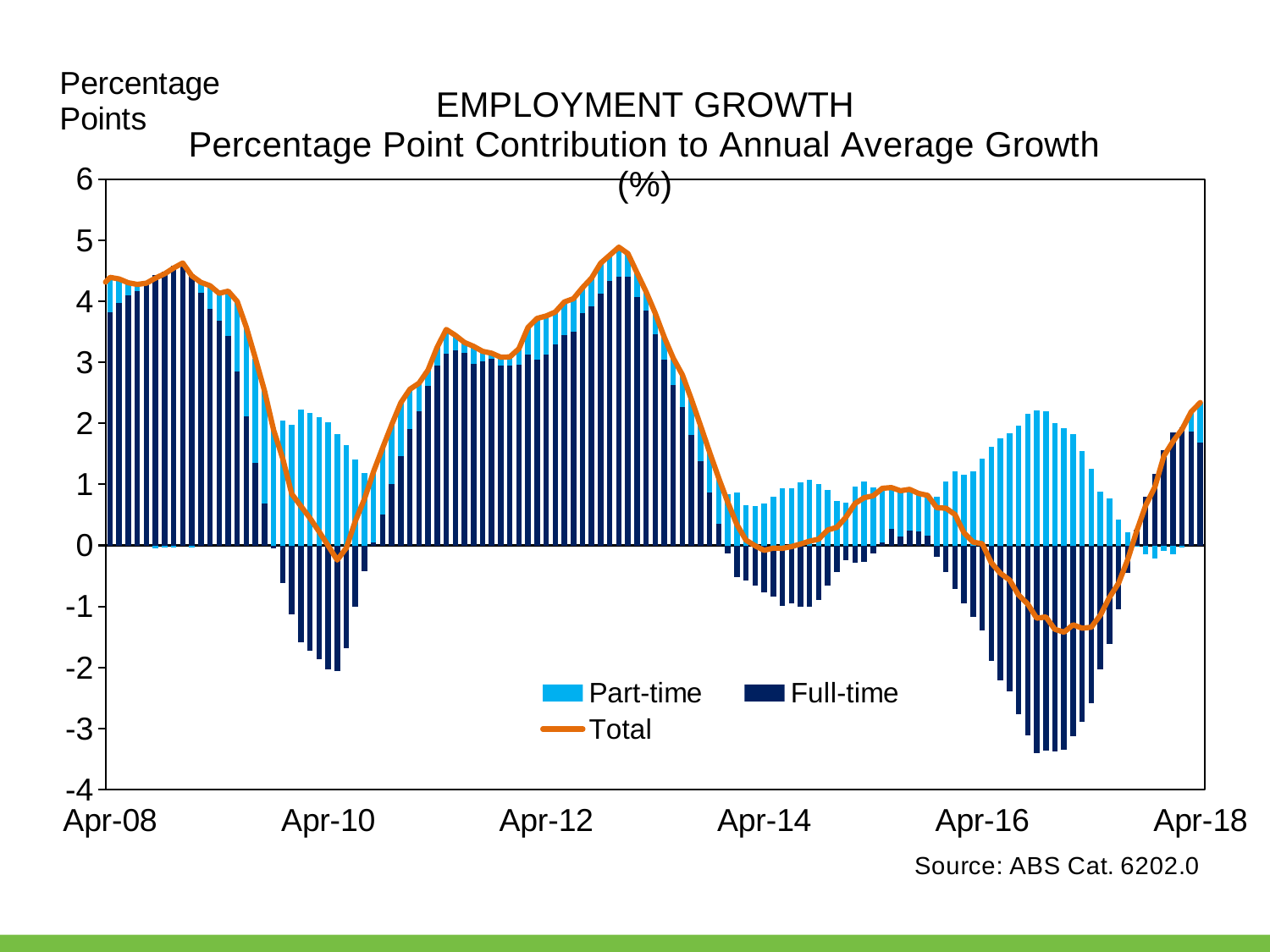
Is the lowest Full-time bar (around late 2016) greater or less than -3? less Does the Total line rise or fall between Apr-12 and Apr-14? fall Is the highest value reached by the Total line greater or less than 4? greater Is the value of the Total line at Apr-08 greater or less than 4? greater How many series does the legend list? 3 What kind of chart is shown on the slide? A combined bar and line chart (stacked bars with a line) What is the source cited below the chart? ABS Cat. 6202.0 What are the names of the series listed in the legend? Part-time, Full-time, Total Which is larger, the Total value at Apr-12 or the Total value at Apr-14? Apr-12